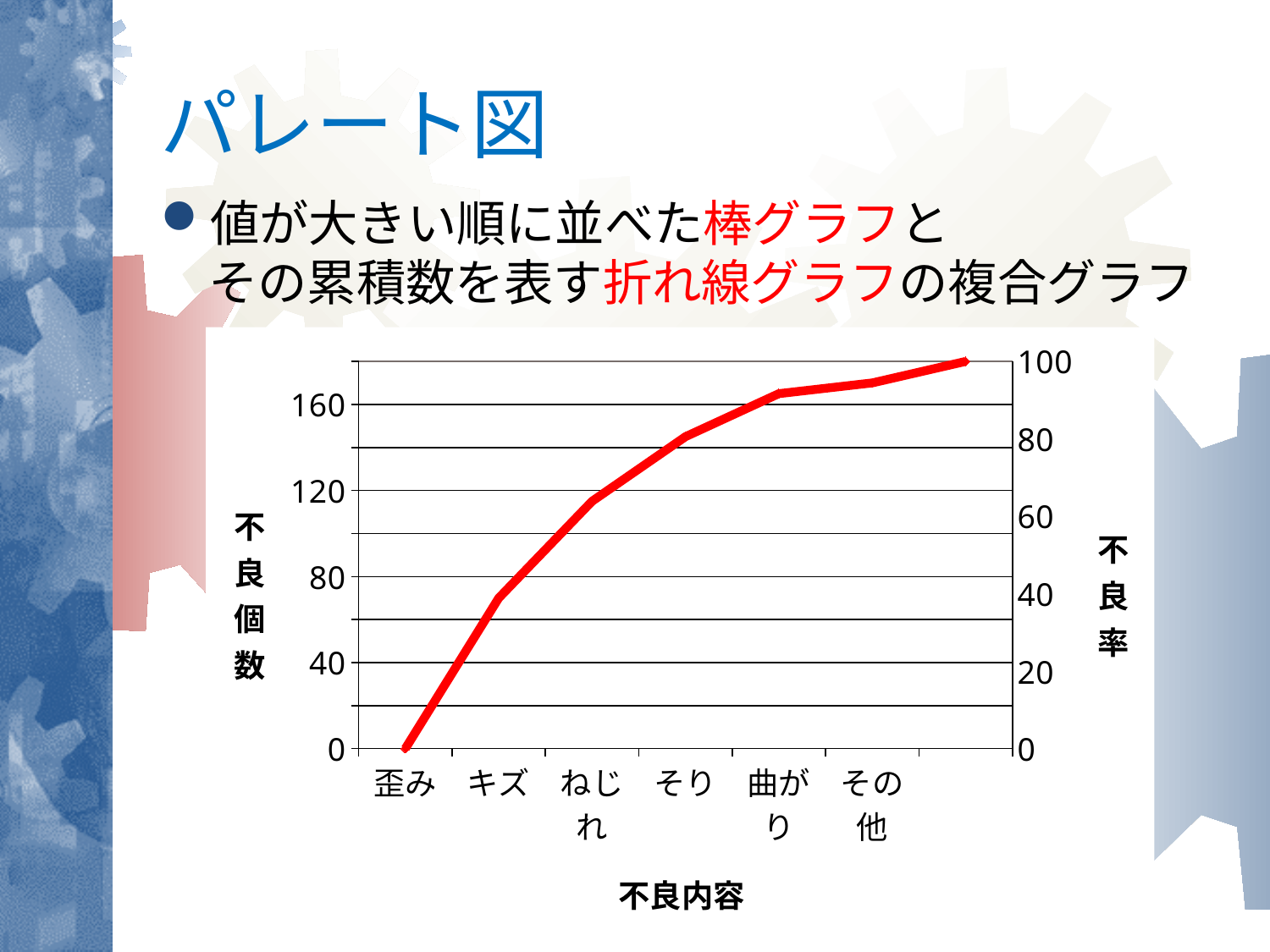
Is the value of the red line at 曲がり greater or less than 80 on the right axis? greater What kind of chart is plotted on the slide? line chart Is the value of the red line at ねじれ greater or less than 40 on the right axis? greater What is the title of the left vertical axis? 不良個数 How many categories are labelled on the x axis? 6 Is the value of the red line at キズ greater or less than 20 on the right axis? greater What value does the red line start at on the left? 0 What is the title of the right vertical axis? 不良率 Does the red line rise or fall from left to right? rise What value on the right axis does the red line reach at its right end? 100 What is the highest tick value shown on the left vertical axis? 160